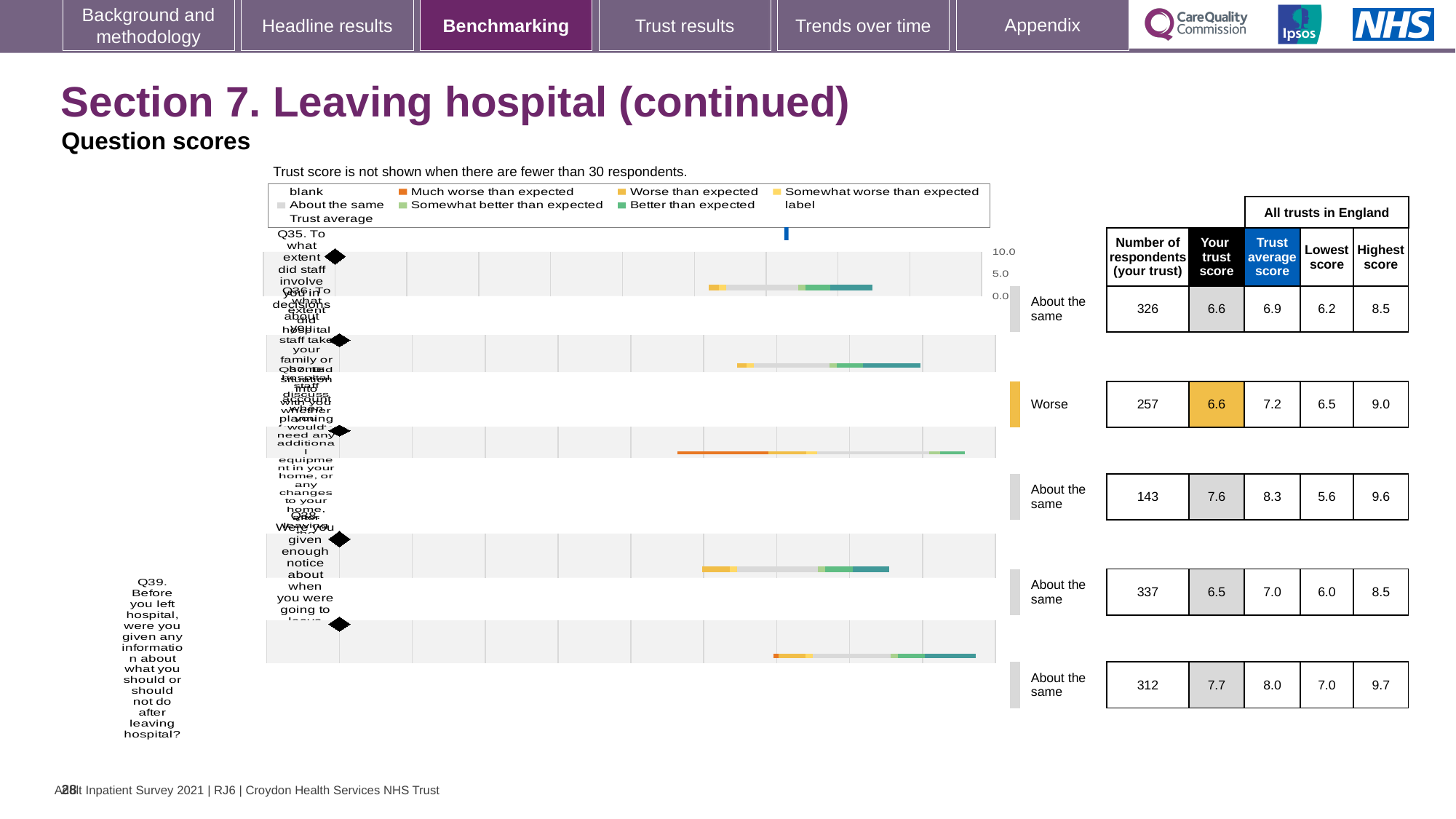
Which question has the highest 'Your trust score' in the table? Q39 Which question has the largest number of respondents (your trust)? Q38 What kind of chart is used to show the question scores on this slide? bar chart Which has the larger 'Your trust score', Q37 or Q39? Q39 What is the 'Your trust score' for Q35 in the question scores table? 6.6 What is the highest score across all trusts in England for Q39? 9.7 How many questions (rows) are plotted in the question scores chart? 5 Which question has the lowest 'Your trust score' in the table? Q38 How many respondents (your trust) are shown for Q37? 143 What is the trust average score for Q38? 7.0 Which question is rated 'Worse' compared with other trusts? Q36 What is the difference between the trust average score and your trust score for Q36? 0.6